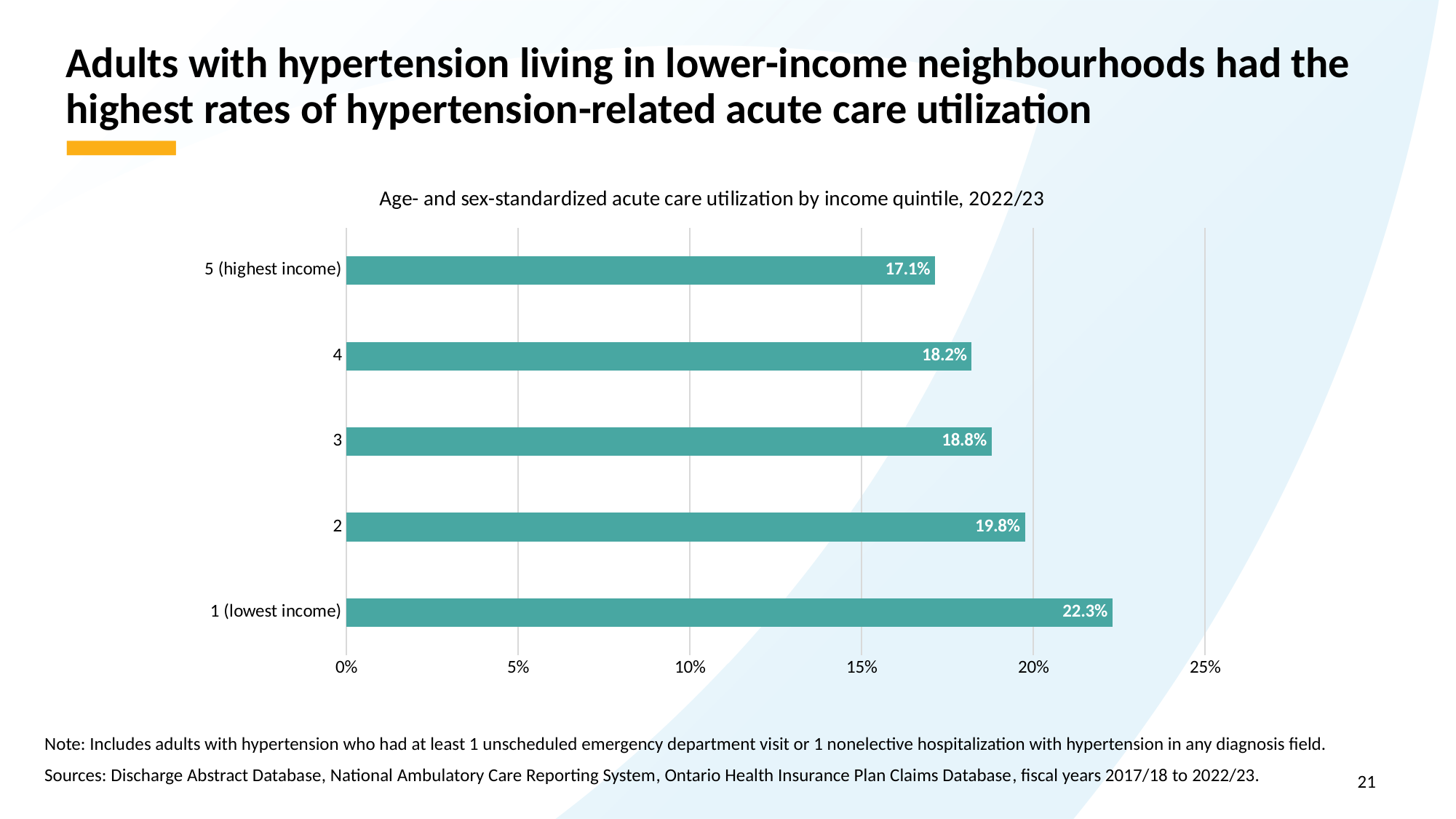
What is the difference in acute care utilization between quintile 2 and quintile 4? 1.6% Which income quintile has the lowest acute care utilization rate? 5 (highest income) What is the acute care utilization rate for income quintile 3? 18.8% What is the title of the chart? Age- and sex-standardized acute care utilization by income quintile, 2022/23 What is the acute care utilization rate for income quintile 5 (highest income)? 17.1% Which has a higher acute care utilization rate, quintile 2 or quintile 3? 2 Is the value for quintile 1 (lowest income) greater or less than 20%? greater How many income quintiles are shown in the chart? 5 What is the acute care utilization rate for income quintile 1 (lowest income)? 22.3% What is the difference in acute care utilization between quintile 1 (lowest income) and quintile 5 (highest income)? 5.2% What kind of chart is shown on the slide? Bar chart Which income quintile has the highest acute care utilization rate? 1 (lowest income)